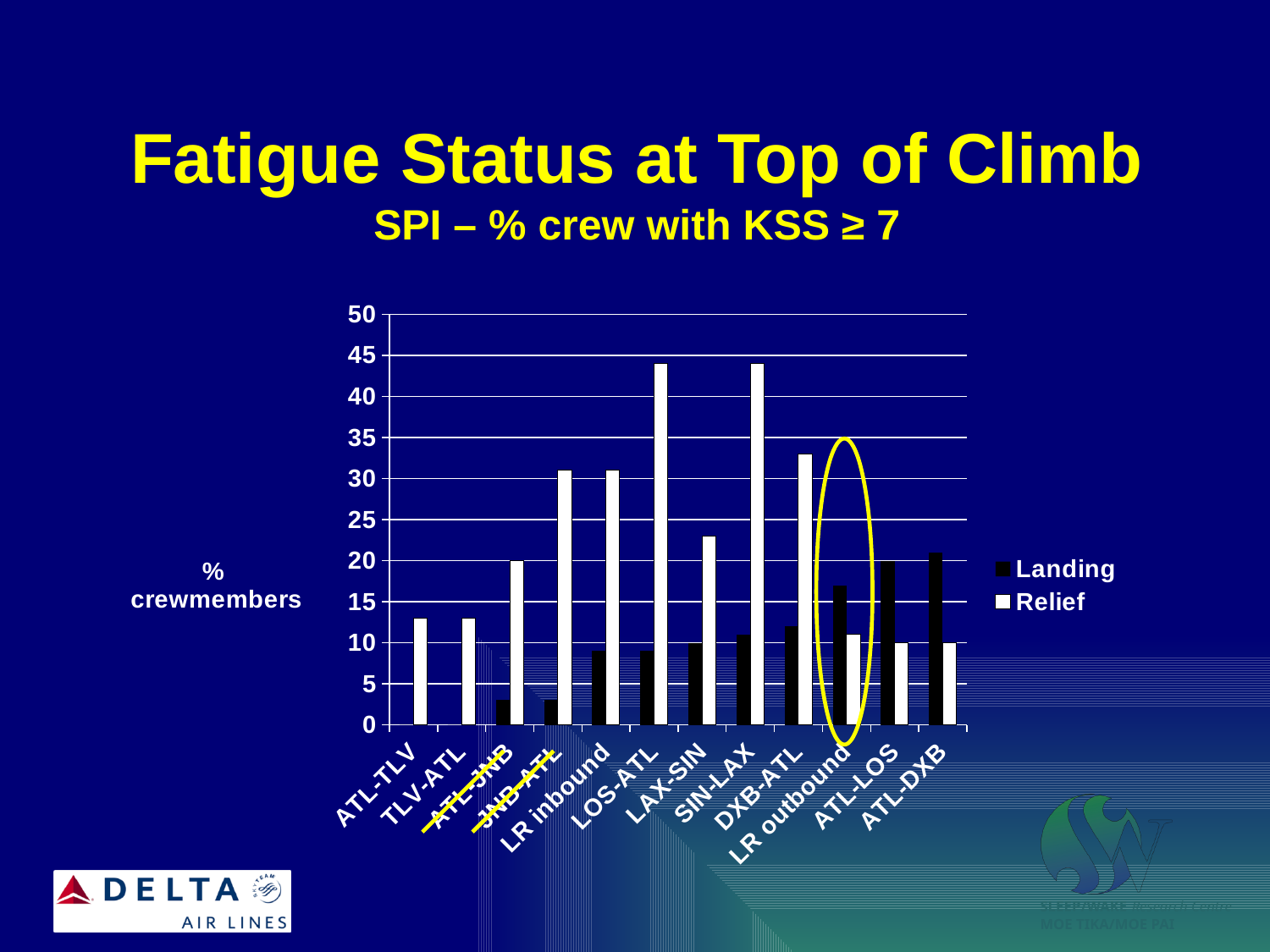
How many categories are shown on the x axis of the chart? 12 What kind of chart is shown on the slide? bar chart Which series is shown in black in the chart? Landing Is the Relief value for LOS-ATL greater or less than 40? greater How many series does the legend list? 2 Is the Relief value for ATL-TLV greater or less than 15? less Is the Landing value for ATL-DXB greater or less than 15? greater Which has the larger Relief value, LAX-SIN or SIN-LAX? SIN-LAX Which is larger for LOS-ATL, the Landing value or the Relief value? Relief Which is larger for ATL-LOS, the Landing value or the Relief value? Landing What is the label on the vertical axis of the chart? % crewmembers